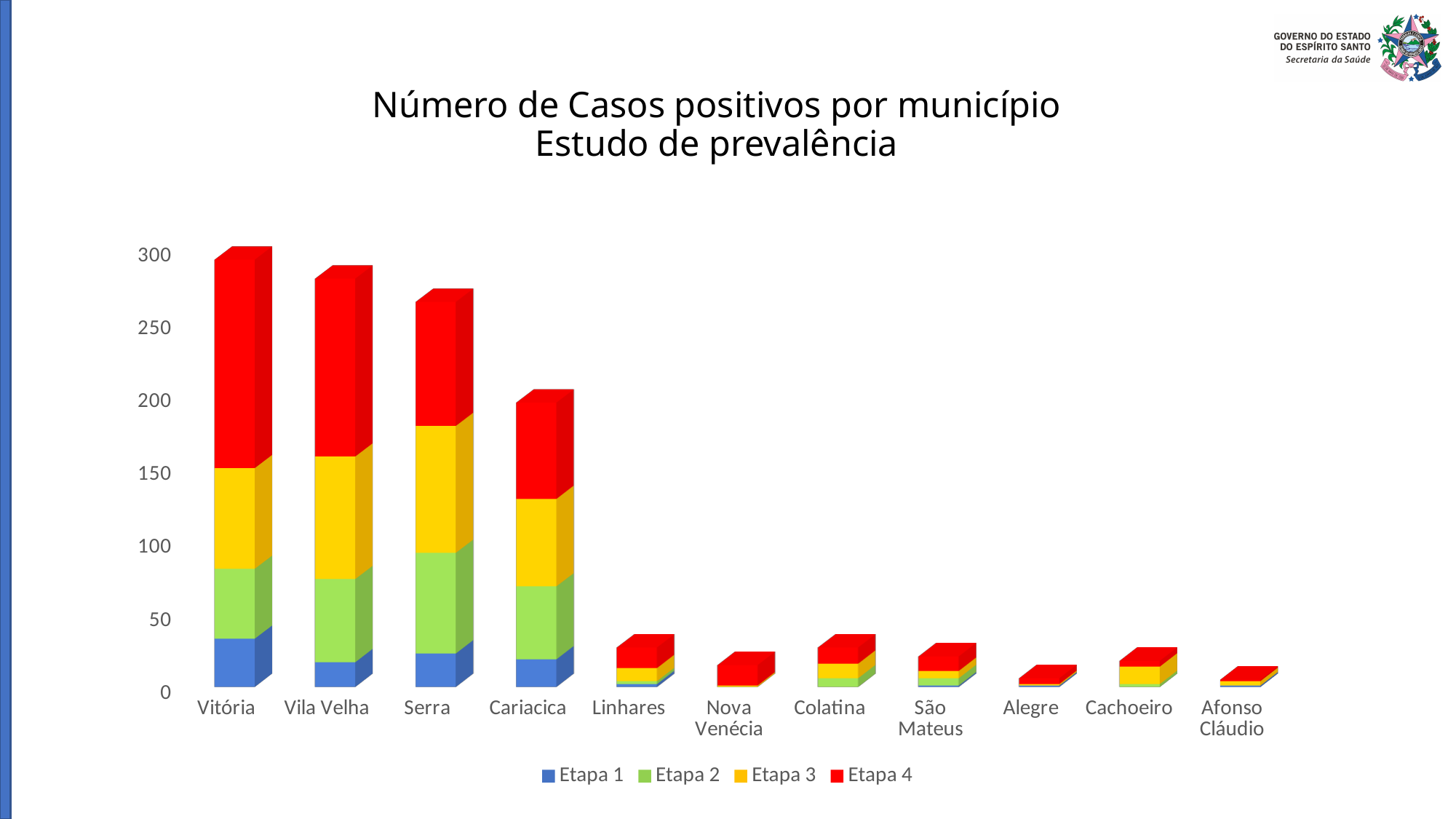
What kind of chart is shown on the slide? Stacked bar chart How many municipalities are shown on the x axis of the chart? 11 Which has a larger total of positive cases, Vitória or Cariacica? Vitória What is the title of the chart? Número de Casos positivos por município Estudo de prevalência Is the total value for Cariacica greater or less than 250? less Is the total value for Linhares greater or less than 50? less Which municipality has the highest total number of positive cases? Vitória Do the total values rise or fall from Vitória to Cariacica across the first four municipalities? fall Which has a larger total of positive cases, Serra or Linhares? Serra How many series does the legend list? 4 Which colour represents Etapa 4 in the legend? Red Is the total value for Vitória greater or less than 250? greater